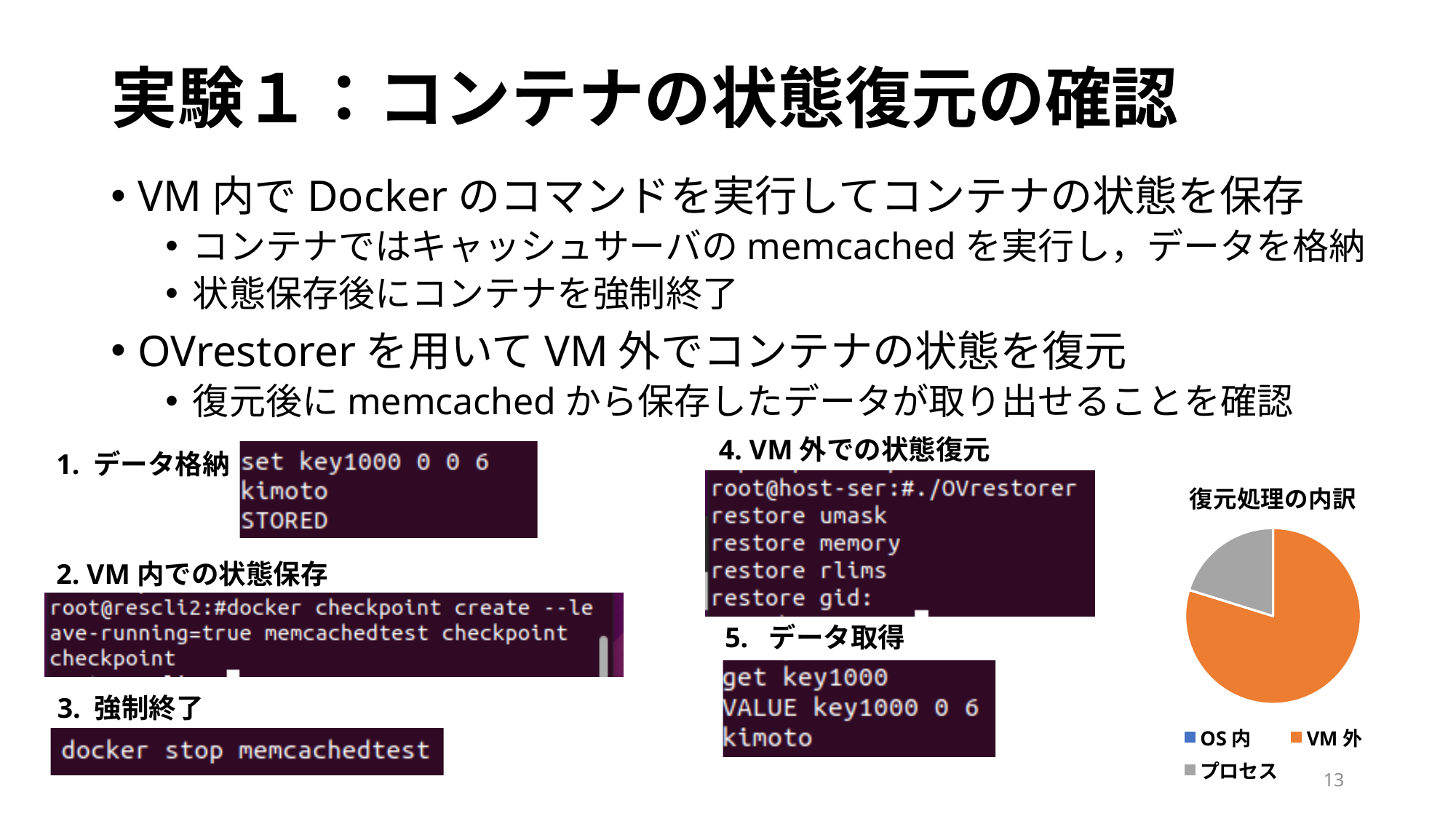
In the pie chart, which slice is larger, VM 外 or プロセス? VM 外 What kind of chart is shown on the slide? pie chart What is the title of the pie chart? 復元処理の内訳 How many categories does the legend of the pie chart list? 3 Which category has the largest slice in the pie chart? VM 外 In the pie chart, which slice is larger, プロセス or OS 内? プロセス Which category has the smallest slice in the pie chart? OS 内 What colour is the VM 外 slice in the pie chart? orange